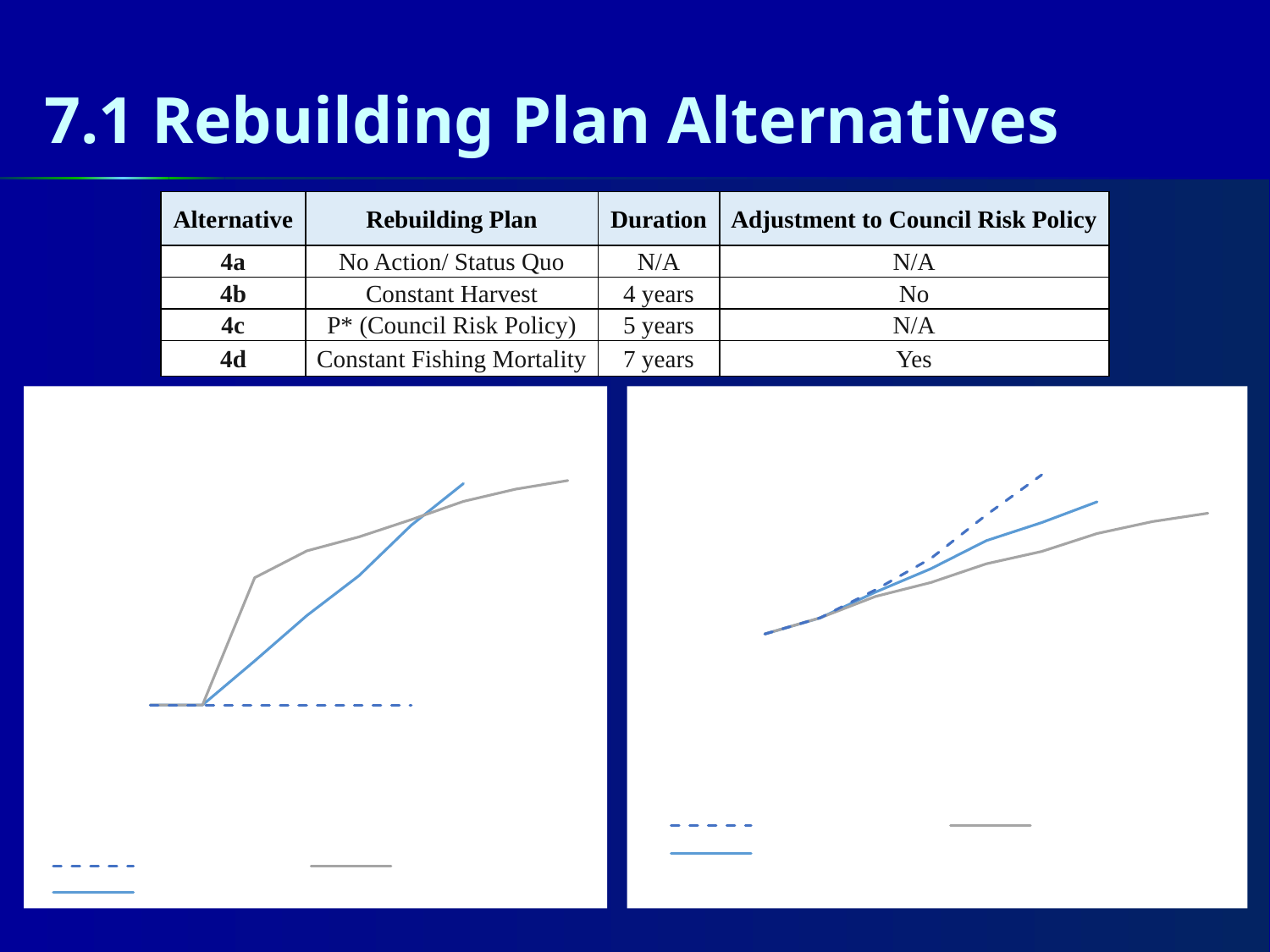
In the right chart, does the dashed blue line rise or fall along the x axis? rise What kind of chart is the chart on the left side of the slide? line chart How many series does the legend of the right chart list? 3 In the left chart, does the grey line rise or fall along the x axis? rise What kind of chart is the chart on the right side of the slide? line chart How many series does the legend of the left chart list? 3 In the right chart, does the grey line rise or fall along the x axis? rise In the right chart, which line reaches the highest point: the dashed blue line, the solid blue line, or the grey line? the dashed blue line In the left chart, which line stays lowest across the chart: the dashed blue line, the solid blue line, or the grey line? the dashed blue line How many charts are shown on the slide? 2